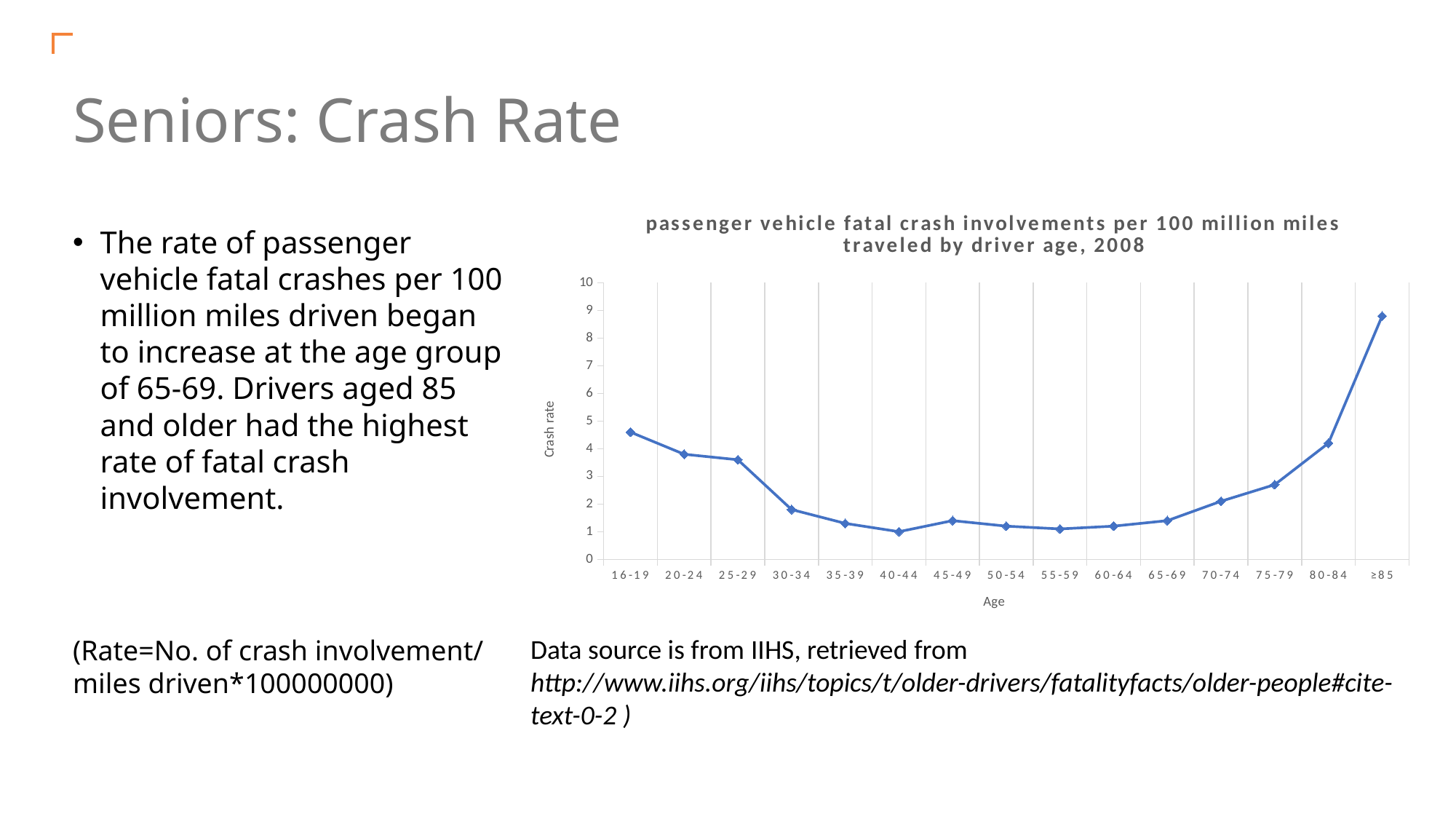
Does the crash rate rise or fall from the 65-69 age group to the ≥85 age group? rise Is the crash rate for the 80-84 age group greater or less than 4? greater Which age group has a higher crash rate, 16-19 or 20-24? 16-19 What kind of chart is shown on the slide? line chart How many age groups are plotted on the x axis? 15 Which age group has the highest crash rate? ≥85 Is the crash rate for the 75-79 age group greater or less than 3? less What is the label on the vertical axis of the chart? Crash rate Is the crash rate for the 30-34 age group greater or less than 2? less Which age group has a higher crash rate, 25-29 or 30-34? 25-29